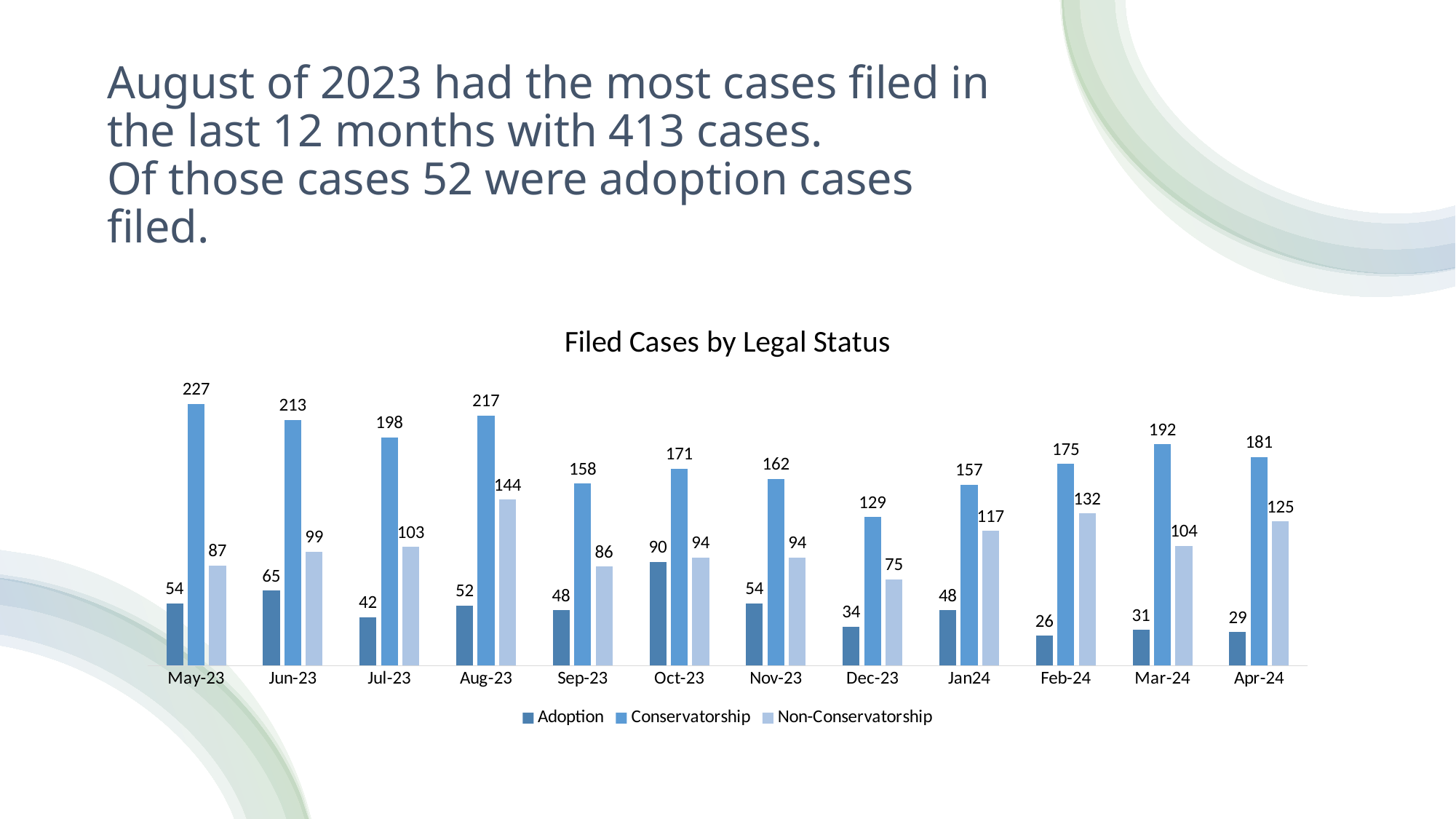
What kind of chart is shown on the slide? Bar chart What is the Non-Conservatorship value for Feb-24? 132 Which month has the highest Conservatorship value? May-23 How many months are shown on the x axis? 12 What is the total of the three series for Aug-23? 413 What is the title of the chart? Filed Cases by Legal Status Which month has the lowest Adoption value? Feb-24 How many series does the legend list? 3 What is the Conservatorship value for Aug-23? 217 What is the difference between the Conservatorship values for May-23 and Apr-24? 46 Which is larger, the Non-Conservatorship value for Aug-23 or for Jan24? Aug-23 What is the Adoption value for Oct-23? 90